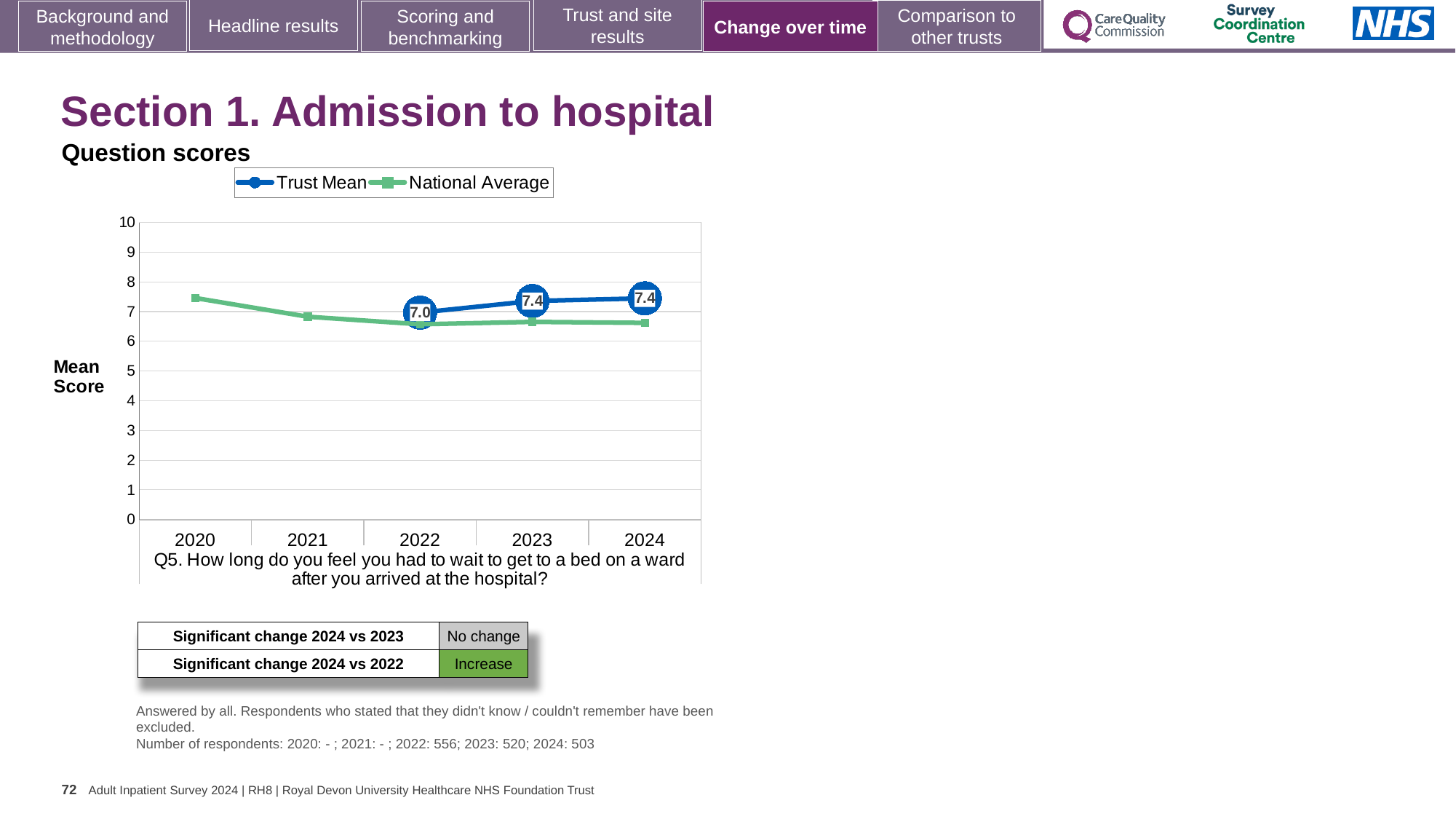
In 2024, which is higher: the Trust Mean or the National Average? Trust Mean How many series does the chart legend list? 2 What is the Trust Mean value for 2024? 7.4 Is the National Average value for 2022 greater or less than 7? less What is the difference between the Trust Mean in 2023 and in 2022? 0.4 How many years are shown on the x axis of the chart? 5 In which year is the Trust Mean lowest? 2022 What is the Trust Mean value for 2023? 7.4 What is the Trust Mean value for 2022? 7.0 What kind of chart is shown on the slide? line chart Is the National Average value for 2020 greater or less than 7? greater Does the Trust Mean rise or fall from 2022 to 2024? rise